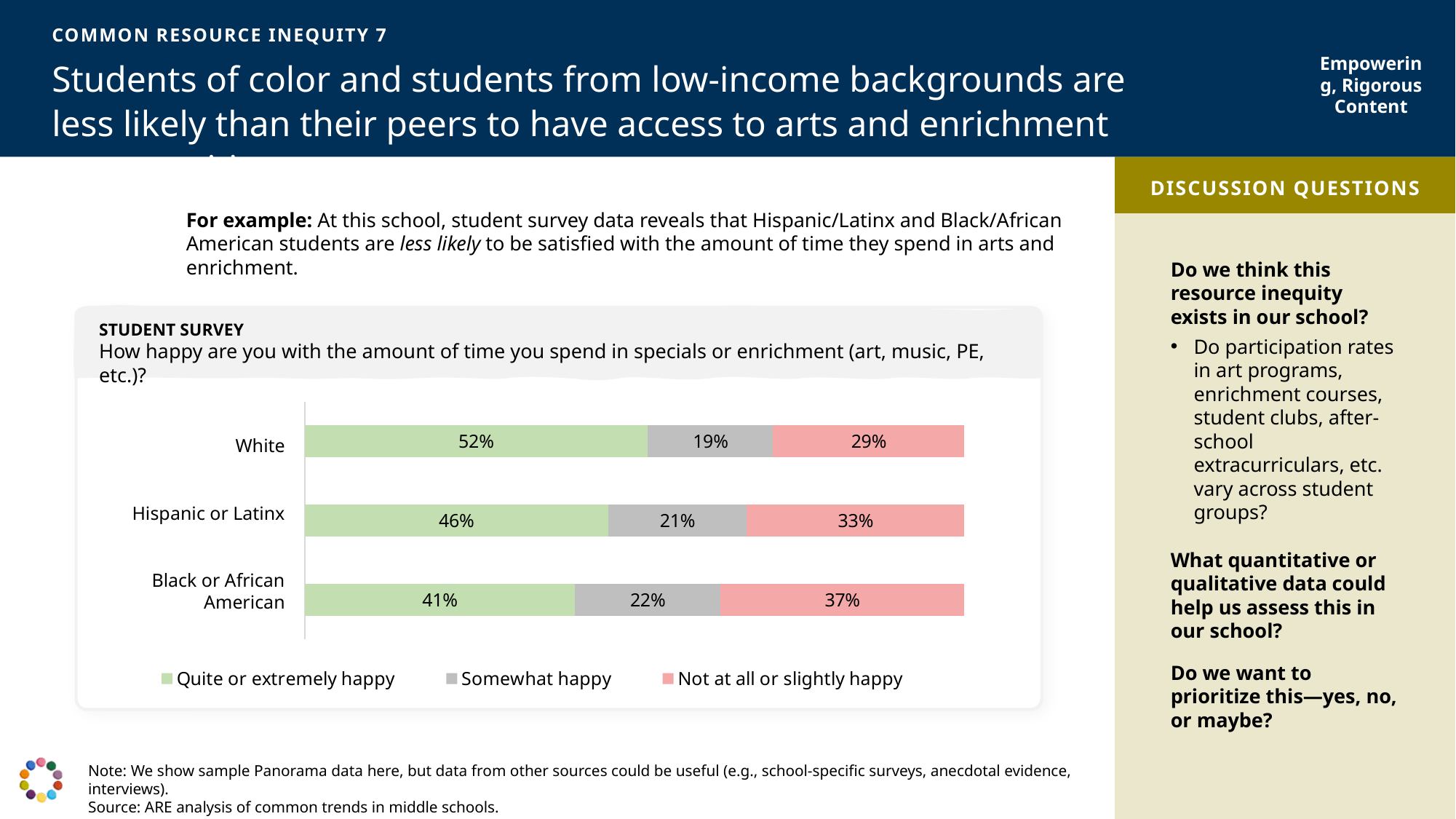
How many student groups are shown in the chart? 3 Which student group has the highest share of not at all or slightly happy responses? Black or African American What percentage of White students are quite or extremely happy with the amount of time spent in specials or enrichment? 52% What is the total of the three segments for the Hispanic or Latinx bar? 100% Which is larger: the not at all or slightly happy share for Hispanic or Latinx students or for White students? Hispanic or Latinx What is the difference between the quite or extremely happy percentages for White and Black or African American students? 11 percentage points What percentage of Black or African American students are somewhat happy? 22% Which student group has the highest share of quite or extremely happy responses? White What percentage of Hispanic or Latinx students are not at all or slightly happy? 33% How many series does the legend list? 3 Which student group has the lowest share of quite or extremely happy responses? Black or African American What kind of chart is shown on the slide? Stacked bar chart